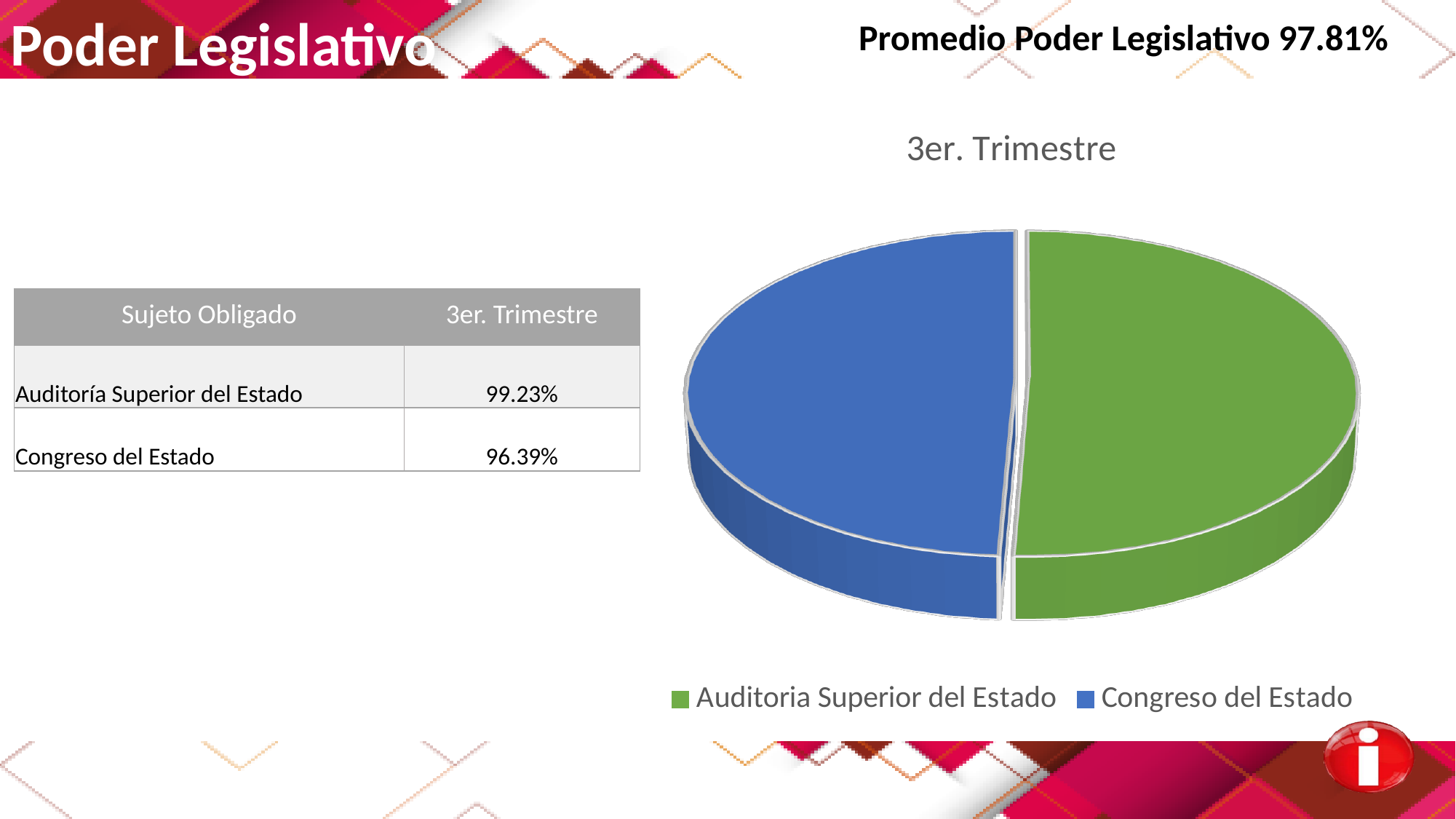
What is the 3er. Trimestre value for Congreso del Estado? 96.39% What is the title of the pie chart? 3er. Trimestre How many slices does the pie chart have? 2 Which sujeto obligado has the lowest 3er. Trimestre value? Congreso del Estado What kind of chart is shown on the slide? Pie chart What is the difference between the 3er. Trimestre values of Auditoría Superior del Estado and Congreso del Estado? 2.84% Which has the higher 3er. Trimestre value, Auditoría Superior del Estado or Congreso del Estado? Auditoría Superior del Estado What is the 3er. Trimestre value for Auditoría Superior del Estado? 99.23% How many entries does the pie chart's legend list? 2 Which colour represents Auditoria Superior del Estado in the pie chart? Green What is the Promedio Poder Legislativo shown on the slide? 97.81%